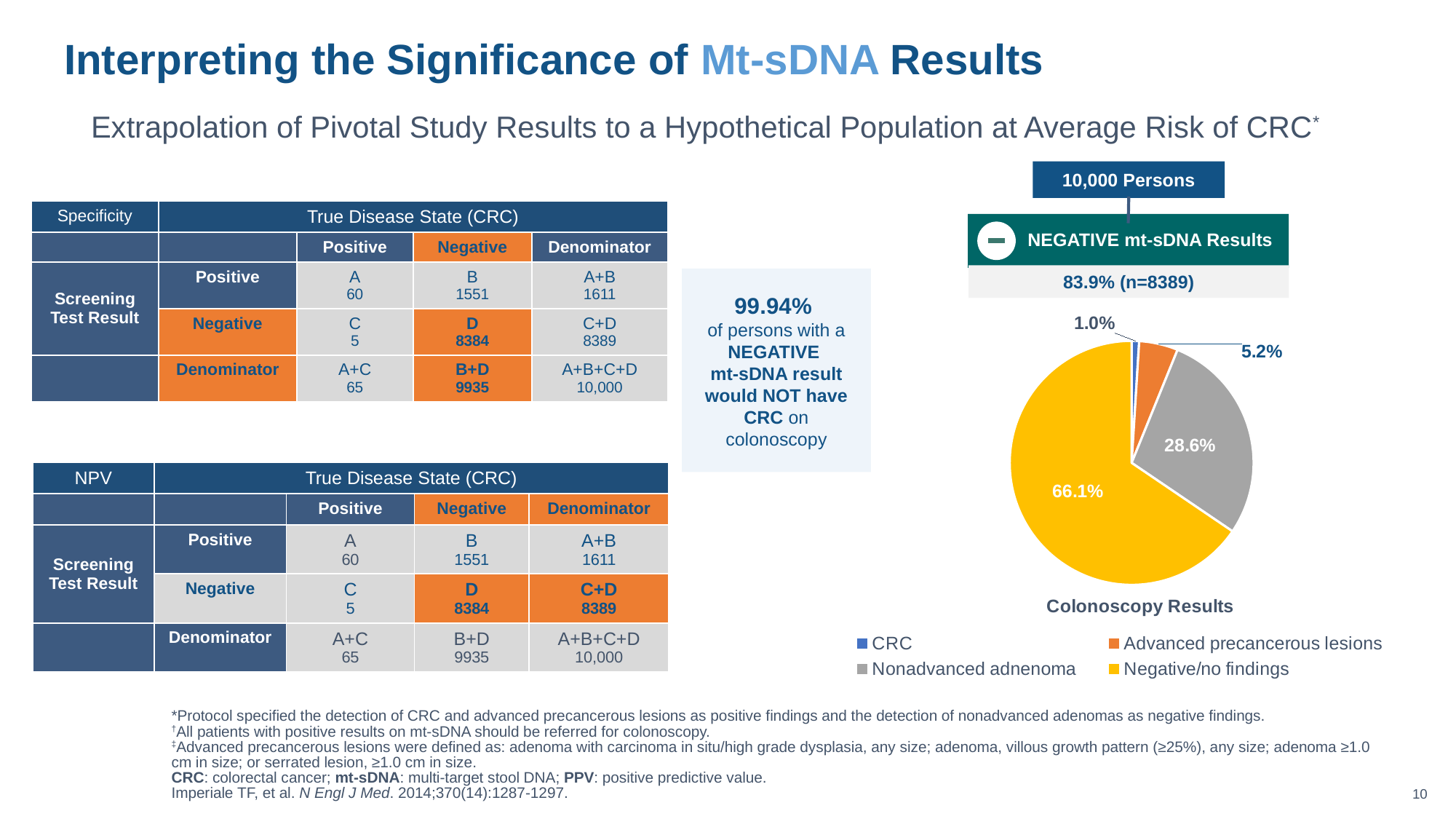
In the Colonoscopy Results pie chart, what share is labelled for Negative/no findings? 66.1% In the Colonoscopy Results pie chart, what share is labelled for CRC? 1.0% Which slice of the Colonoscopy Results pie chart is the smallest? CRC In the Colonoscopy Results pie chart, what colour is the Negative/no findings slice? yellow Which slice of the Colonoscopy Results pie chart is the largest? Negative/no findings How many slices does the Colonoscopy Results pie chart have? 4 In the Colonoscopy Results pie chart, what is the difference between the Negative/no findings share and the Nonadvanced adnenoma share? 37.5% What kind of chart is shown under the heading "Colonoscopy Results"? pie chart How many entries does the legend of the Colonoscopy Results pie chart list? 4 In the Colonoscopy Results pie chart, which is larger: Advanced precancerous lesions or CRC? Advanced precancerous lesions In the Colonoscopy Results pie chart, what share is labelled for Nonadvanced adnenoma? 28.6%